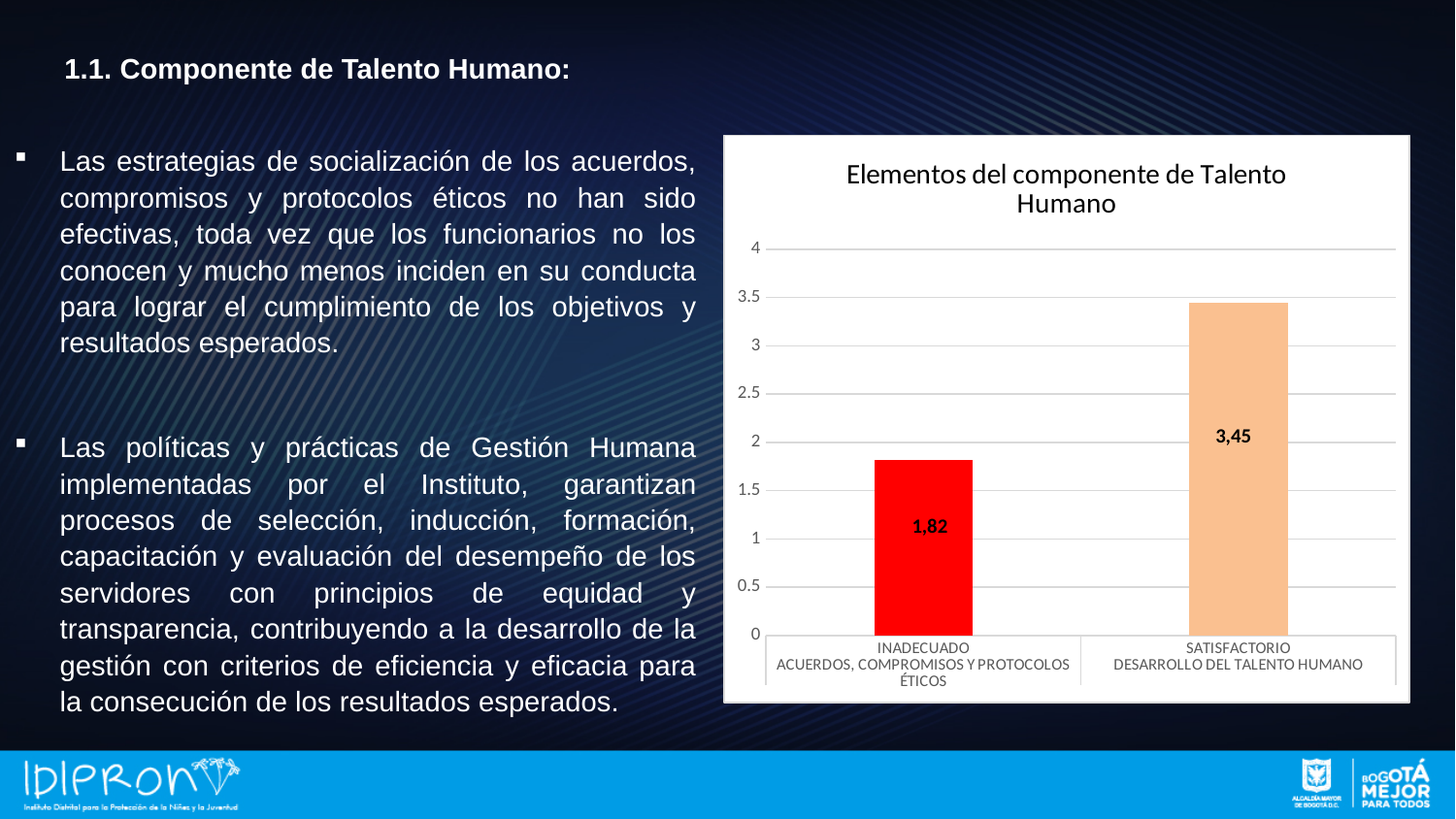
Which is larger, the value for ACUERDOS, COMPROMISOS Y PROTOCOLOS ÉTICOS or the value for DESARROLLO DEL TALENTO HUMANO? DESARROLLO DEL TALENTO HUMANO Which category has the lowest value? ACUERDOS, COMPROMISOS Y PROTOCOLOS ÉTICOS What colour is the bar for ACUERDOS, COMPROMISOS Y PROTOCOLOS ÉTICOS? red Is the value for ACUERDOS, COMPROMISOS Y PROTOCOLOS ÉTICOS greater or less than 2? less What is the value for ACUERDOS, COMPROMISOS Y PROTOCOLOS ÉTICOS? 1,82 How many categories are shown in the chart? 2 What kind of chart is shown on the slide? bar chart Is the value for DESARROLLO DEL TALENTO HUMANO greater or less than 3? greater What is the title of the chart? Elementos del componente de Talento Humano What is the difference between the values for DESARROLLO DEL TALENTO HUMANO and ACUERDOS, COMPROMISOS Y PROTOCOLOS ÉTICOS? 1,63 What is the value for DESARROLLO DEL TALENTO HUMANO? 3,45 Which category has the highest value? DESARROLLO DEL TALENTO HUMANO